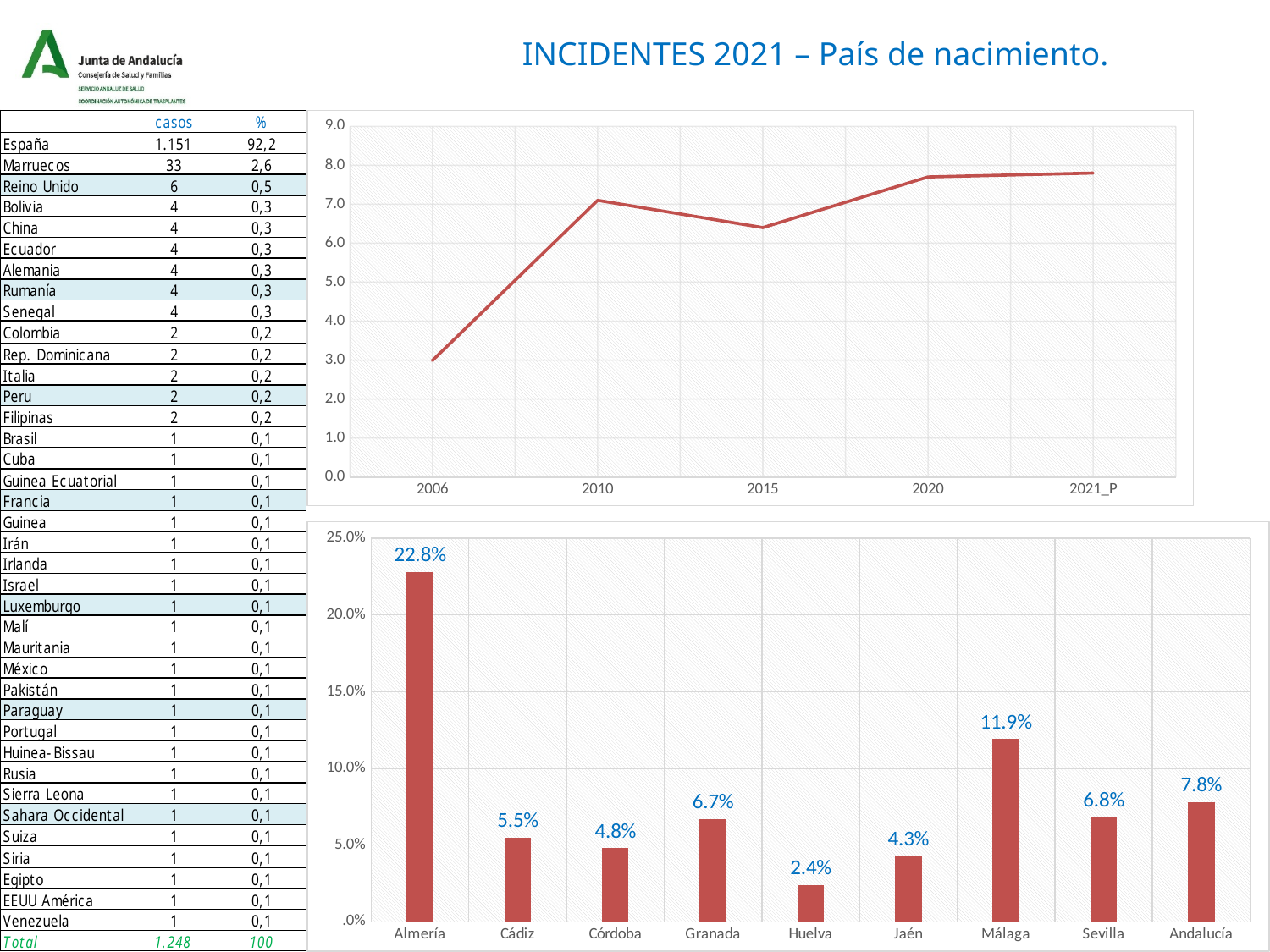
In the line chart at the top right of the slide, is the value for 2006 greater or less than 4.0? less In the bar chart at the bottom of the slide, what is the value for Huelva? 2.4% In the bar chart at the bottom of the slide, what is the value for Málaga? 11.9% In the bar chart at the bottom of the slide, what is the difference between the values for Almería and Málaga? 10.9% What kind of chart is the chart at the top right of the slide? Line chart In the line chart at the top right of the slide, is the value for 2020 greater or less than 7.0? greater In the bar chart at the bottom of the slide, which is larger, the value for Granada or the value for Cádiz? Granada In the bar chart at the bottom of the slide, how many categories are shown on the x axis? 9 In the bar chart at the bottom of the slide, what is the value for Almería? 22.8% In the line chart at the top right of the slide, does the value rise or fall from 2006 to 2010? rise In the bar chart at the bottom of the slide, which category has the highest value? Almería In the bar chart at the bottom of the slide, which category has the lowest value? Huelva